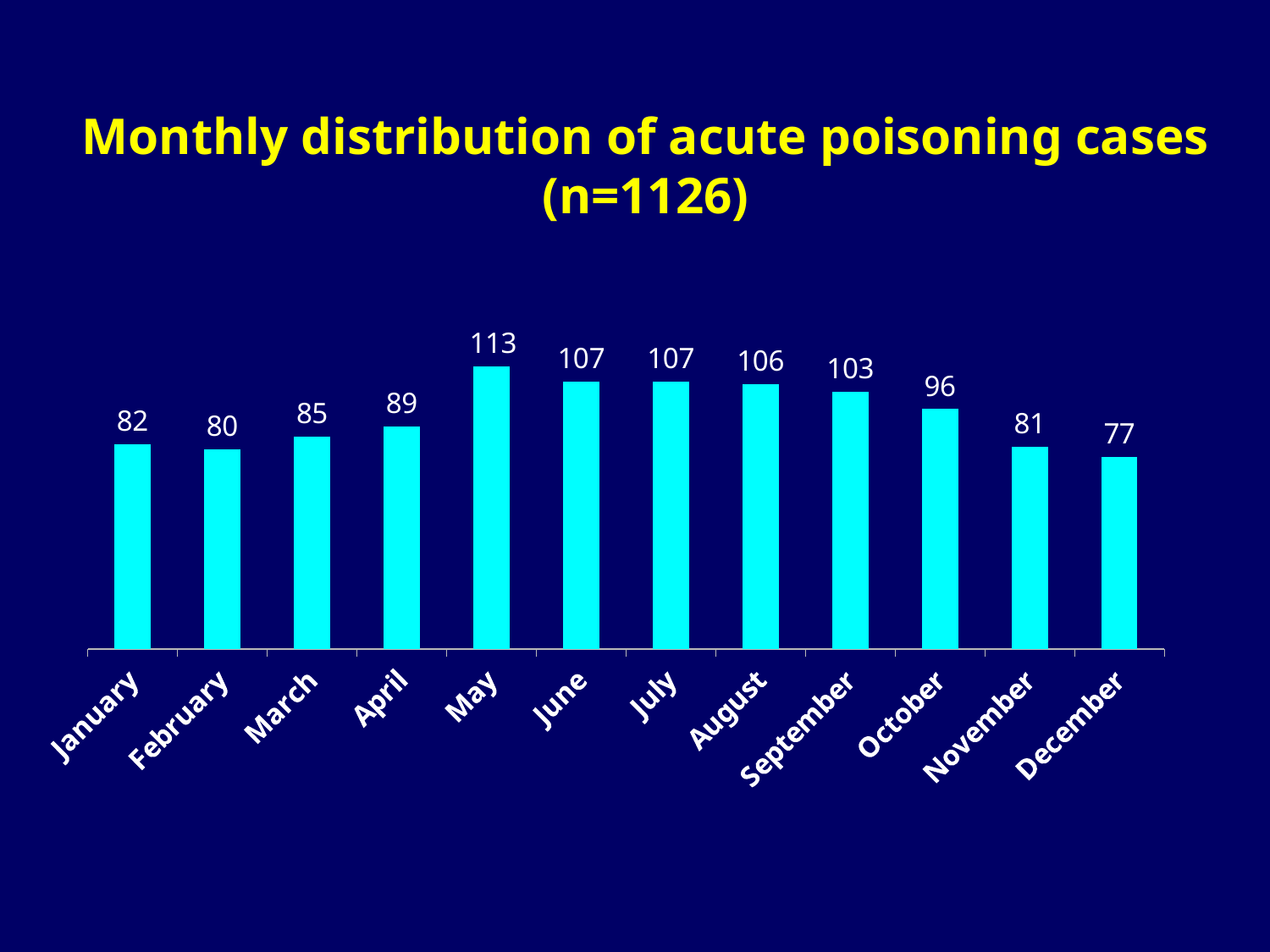
What is the value for May? 113 Which month has the highest value? May Which month has the lowest value? December What is the difference between the values for October and November? 15 Which is larger, the value for April or the value for August? August What is the title of the chart? Monthly distribution of acute poisoning cases (n=1126) What kind of chart is shown on the slide? Bar chart Do the values rise or fall from May to December? Fall What is the value for September? 103 What is the difference between the values for May and December? 36 How many months are shown on the chart? 12 What is the value for December? 77